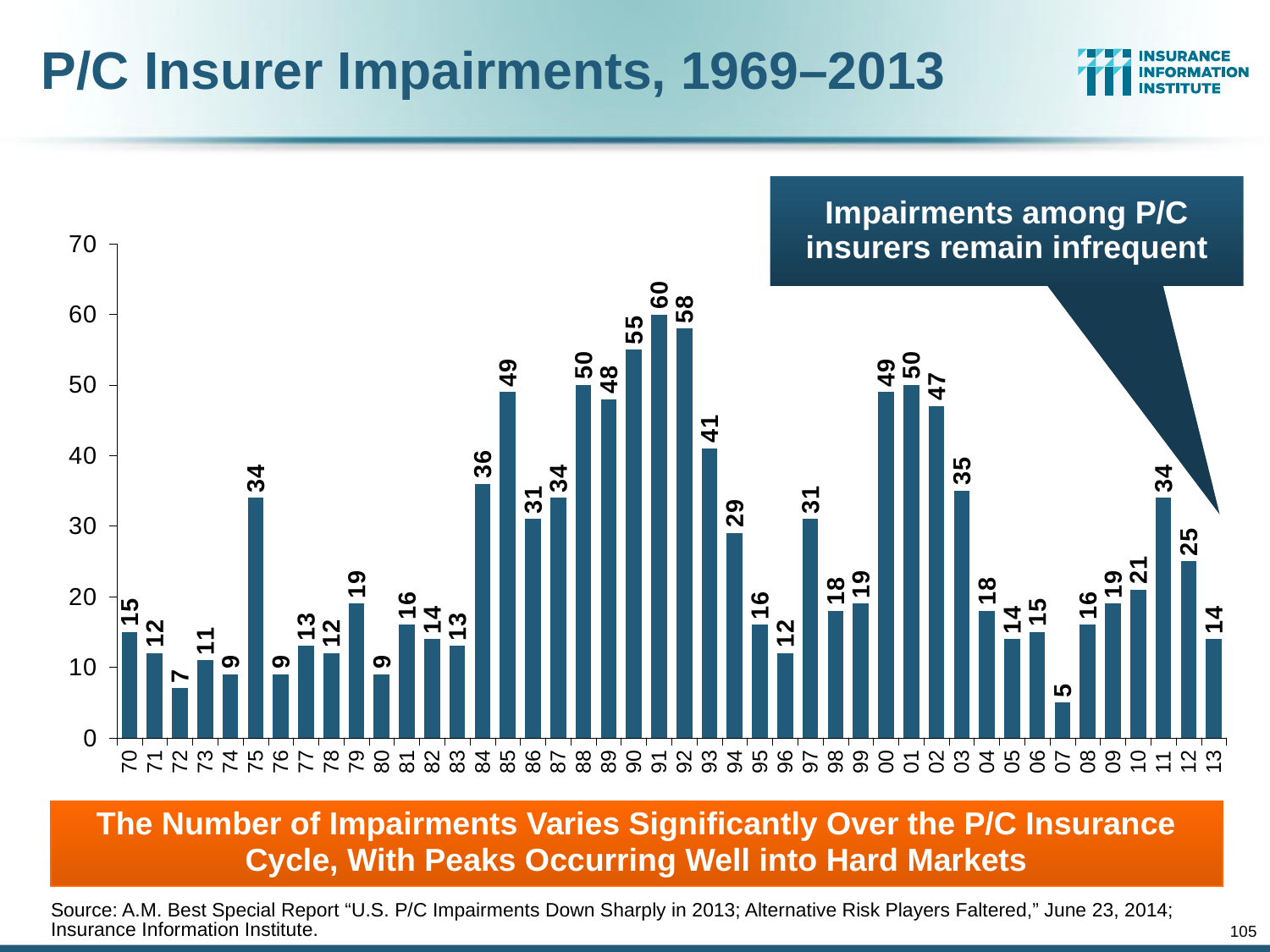
Which year has the highest number of impairments? 91 What is the title of the chart on the slide? P/C Insurer Impairments, 1969–2013 Is the value for '03' greater or less than 30? greater What value is shown for the bar labeled '07'? 5 What is the number of P/C insurer impairments shown for 1991 (label '91')? 60 What is the value for the bar labeled '13'? 14 What kind of chart is shown on the slide? Bar chart Which year has the lowest number of impairments? 07 Which is larger, the value for '85' or the value for '89'? 85 How many bars are plotted in the chart? 44 Do the values rise or fall from '08' to '11'? Rise What is the difference between the values for '92' and '93'? 17